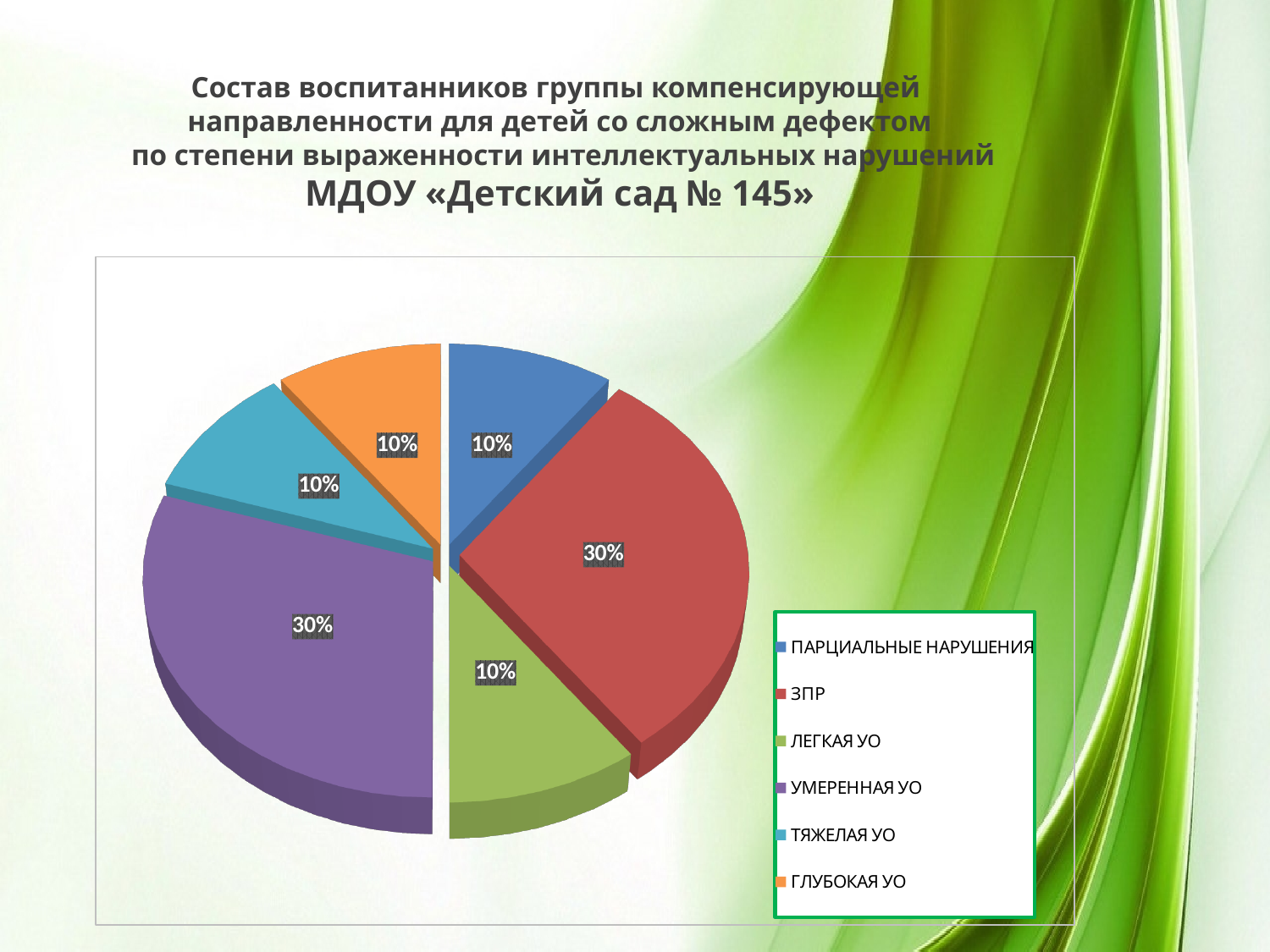
Which is larger, the share for УМЕРЕННАЯ УО or the share for ТЯЖЕЛАЯ УО? УМЕРЕННАЯ УО What is the value shown for ПАРЦИАЛЬНЫЕ НАРУШЕНИЯ? 10% What is the value shown for ЛЕГКАЯ УО? 10% What share of the pie does УМЕРЕННАЯ УО account for? 30% What is the difference between the share for ЗПР and the share for ГЛУБОКАЯ УО? 20% Which colour represents ЗПР in the pie chart? red What share of the pie does ЗПР account for? 30% What is the value shown for ТЯЖЕЛАЯ УО? 10% Which is larger, the share for ЗПР or the share for ЛЕГКАЯ УО? ЗПР How many categories does the pie chart have? 6 What kind of chart is shown on the slide? pie chart What is the value shown for ГЛУБОКАЯ УО? 10%